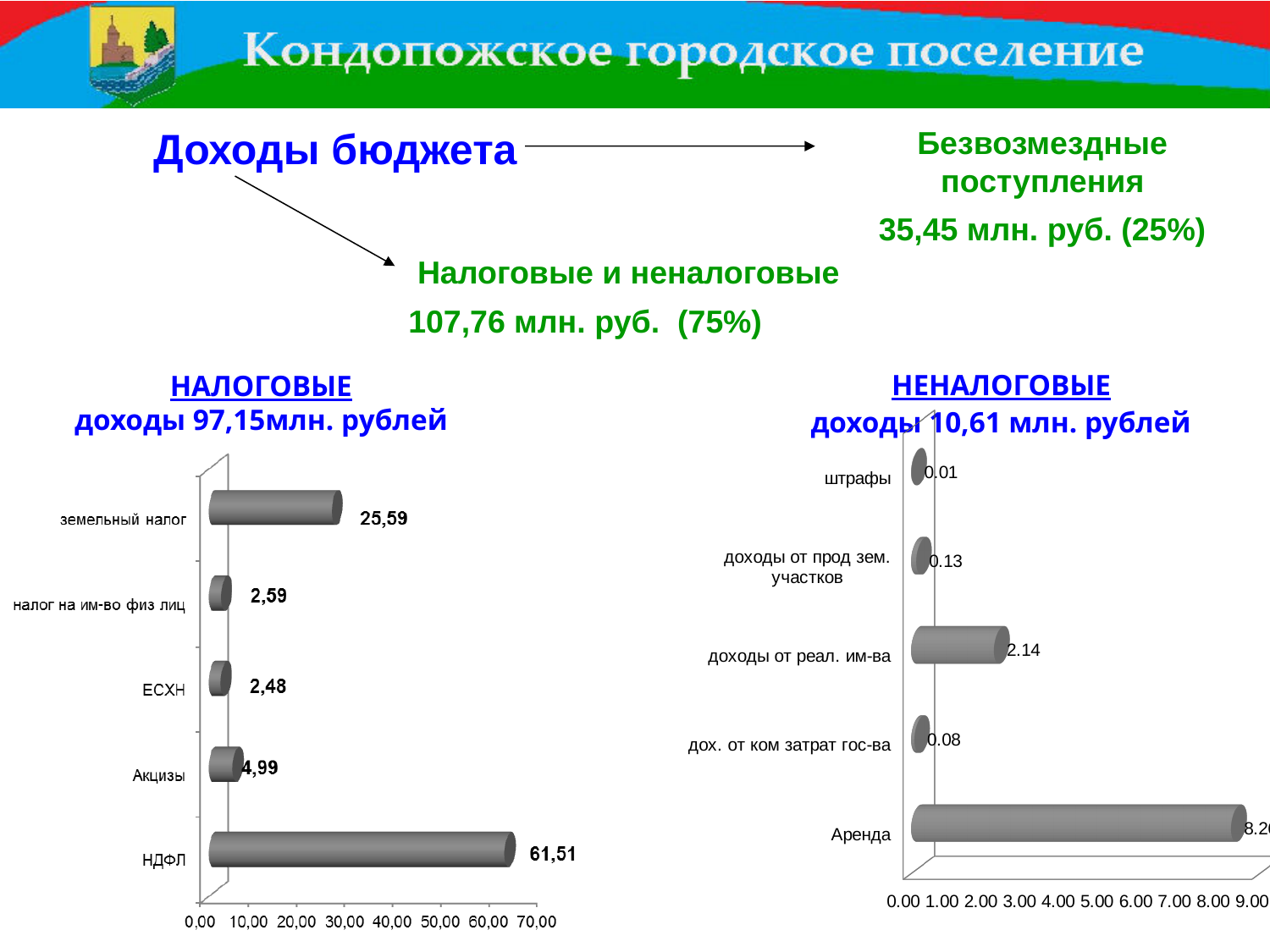
In the НЕНАЛОГОВЫЕ chart, is the value for Аренда greater or less than 8.00? greater In the НЕНАЛОГОВЫЕ chart, what is the value for доходы от реал. им-ва? 2.14 In the НАЛОГОВЫЕ chart, what is the difference between НДФЛ and земельный налог? 35,92 In the НАЛОГОВЫЕ chart, what is the value for земельный налог? 25,59 How many categories are shown in the НАЛОГОВЫЕ chart? 5 In the НАЛОГОВЫЕ chart, which is larger: Акцизы or налог на им-во физ лиц? Акцизы In the НЕНАЛОГОВЫЕ chart, which category has the highest value? Аренда In the НАЛОГОВЫЕ chart, which category has the highest value? НДФЛ In the НЕНАЛОГОВЫЕ chart, what is the value for штрафы? 0.01 In the НАЛОГОВЫЕ chart, what is the value for НДФЛ? 61,51 In the НАЛОГОВЫЕ chart, which category has the lowest value? ЕСХН What kind of chart is the НЕНАЛОГОВЫЕ chart? bar chart